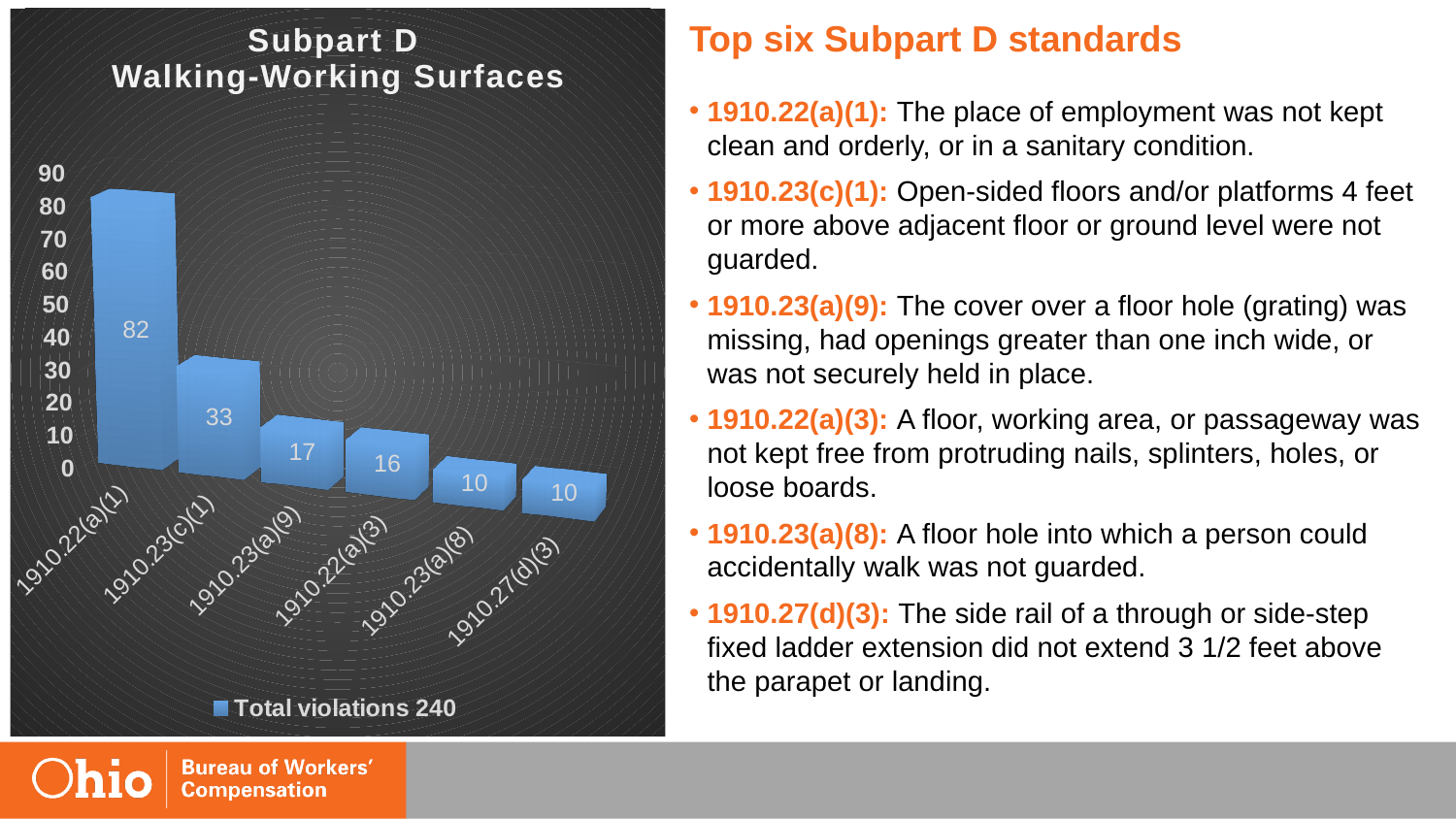
What is the difference between the values for 1910.23(a)(9) and 1910.22(a)(3)? 1 What is the value for 1910.23(c)(1)? 33 Do the values rise or fall from left to right along the x axis? fall What is the legend entry for the series? Total violations 240 How many series does the legend list? 1 Which category has the highest value? 1910.22(a)(1) Which is larger, the value for 1910.23(c)(1) or the value for 1910.23(a)(9)? 1910.23(c)(1) What is the value for 1910.22(a)(1)? 82 What is the difference between the values for 1910.22(a)(1) and 1910.23(c)(1)? 49 How many categories are shown on the x axis? 6 What is the value for 1910.22(a)(3)? 16 What kind of chart is shown? bar chart